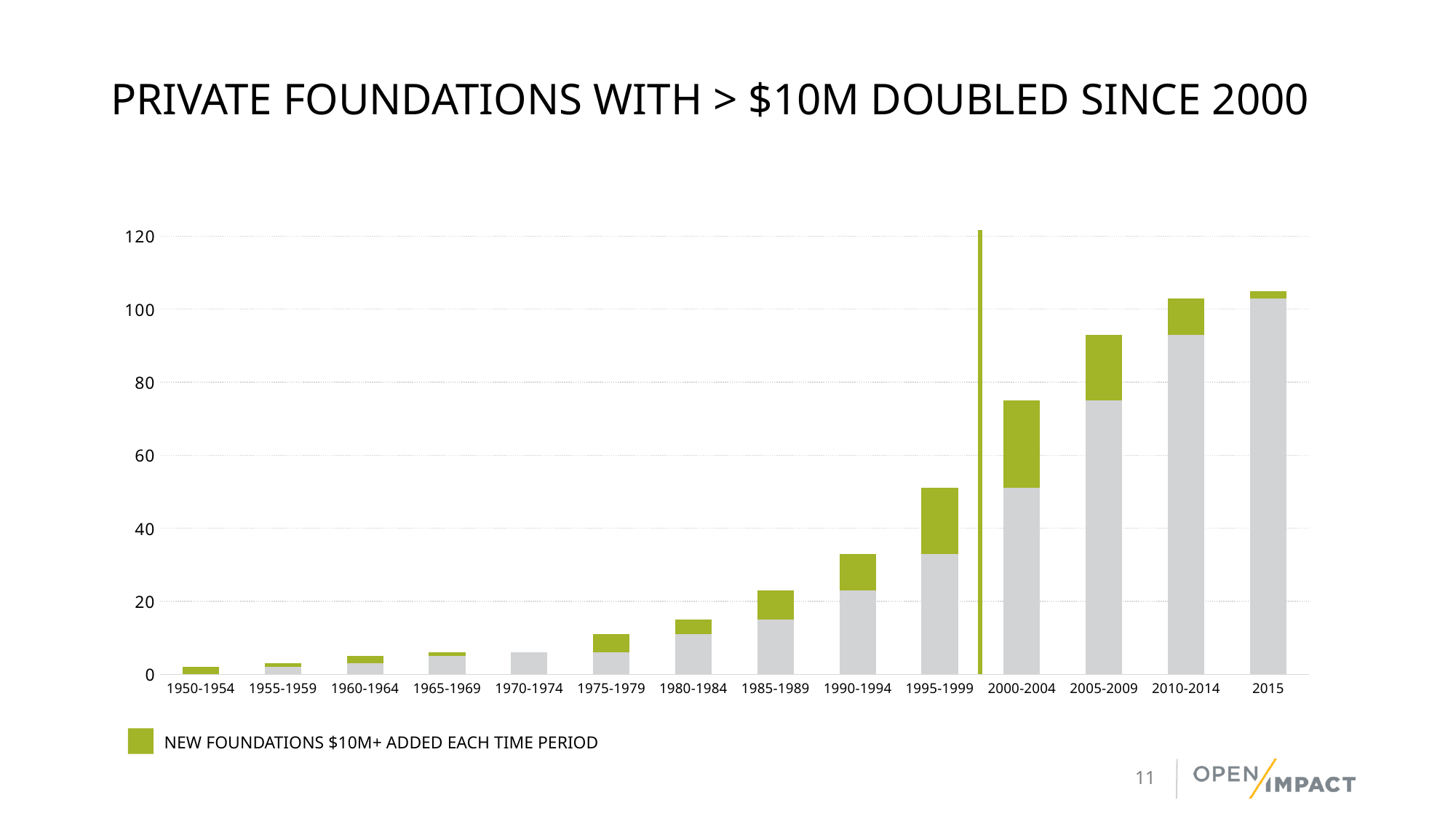
Which time period has the largest green segment (new foundations added)? 2000-2004 How many series does the legend list? 1 Is the total value for 1995-1999 greater or less than 60? less Which has the larger total bar, 2005-2009 or 1995-1999? 2005-2009 Which time period has the lowest total bar? 1950-1954 What is the title of the chart? PRIVATE FOUNDATIONS WITH > $10M DOUBLED SINCE 2000 What does the green segment of each bar represent, according to the legend? NEW FOUNDATIONS $10M+ ADDED EACH TIME PERIOD Do the total bar values generally rise or fall from 1950-1954 to 2015? rise How many time periods are shown along the x axis? 14 Is the total value for 2010-2014 greater or less than 100? greater What kind of chart is shown on the slide? Stacked bar chart Is the total value for 2000-2004 greater or less than 60? greater